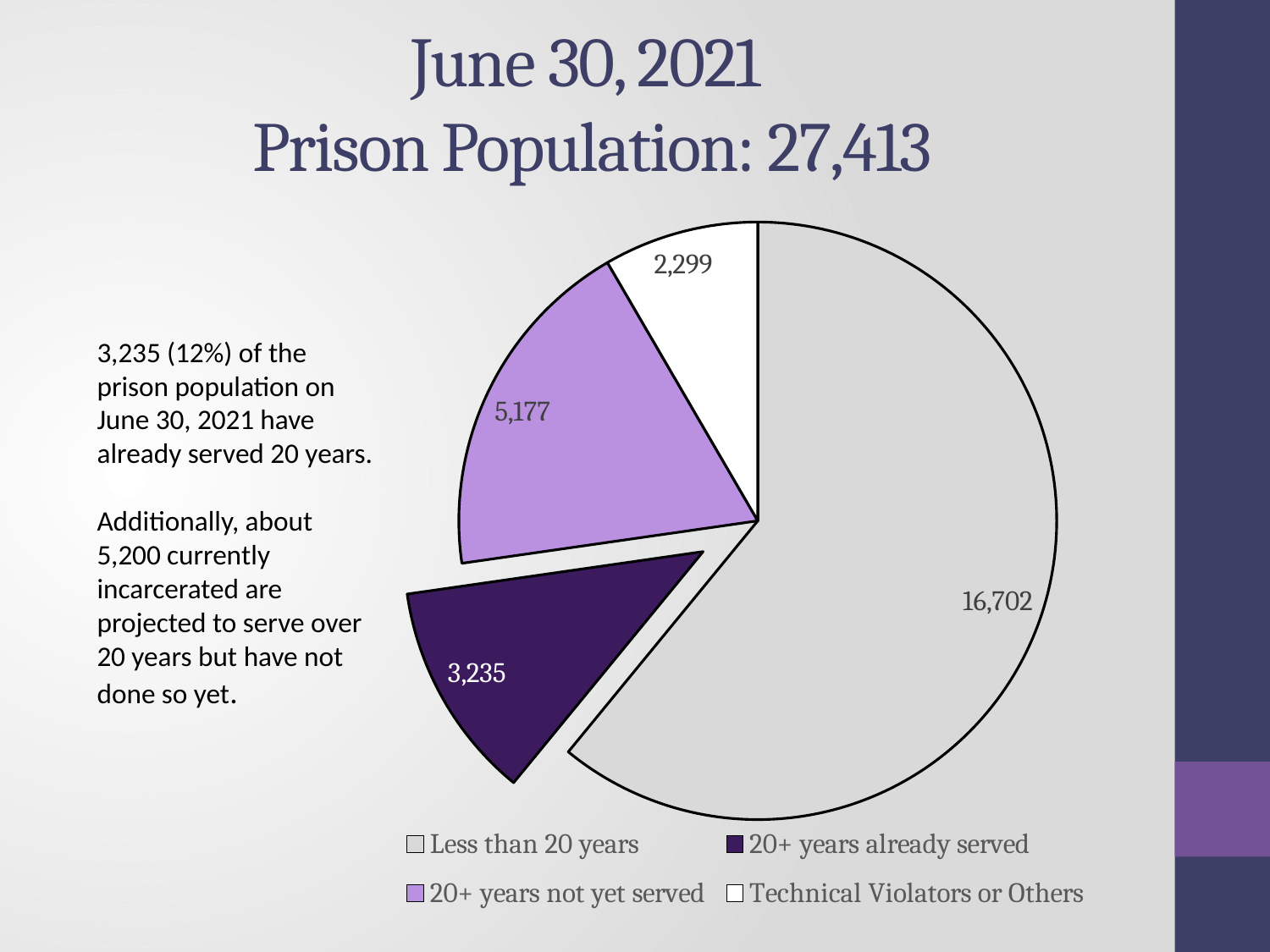
What share of the prison population does the '20+ years already served' slice represent, as stated on the slide? 12% What is the value of the 'Less than 20 years' slice? 16,702 What is the difference between the '20+ years not yet served' value and the 'Technical Violators or Others' value? 2,878 What is the value of the '20+ years not yet served' slice? 5,177 What is the value of the 'Technical Violators or Others' slice? 2,299 How many slices does the pie chart have? 4 What is the value of the '20+ years already served' slice? 3,235 What is the difference between the 'Less than 20 years' value and the '20+ years already served' value? 13,467 Which category has the smallest slice of the pie? Technical Violators or Others What kind of chart is shown on the slide? Pie chart Which category has the largest slice of the pie? Less than 20 years Which is larger, '20+ years not yet served' or '20+ years already served'? 20+ years not yet served